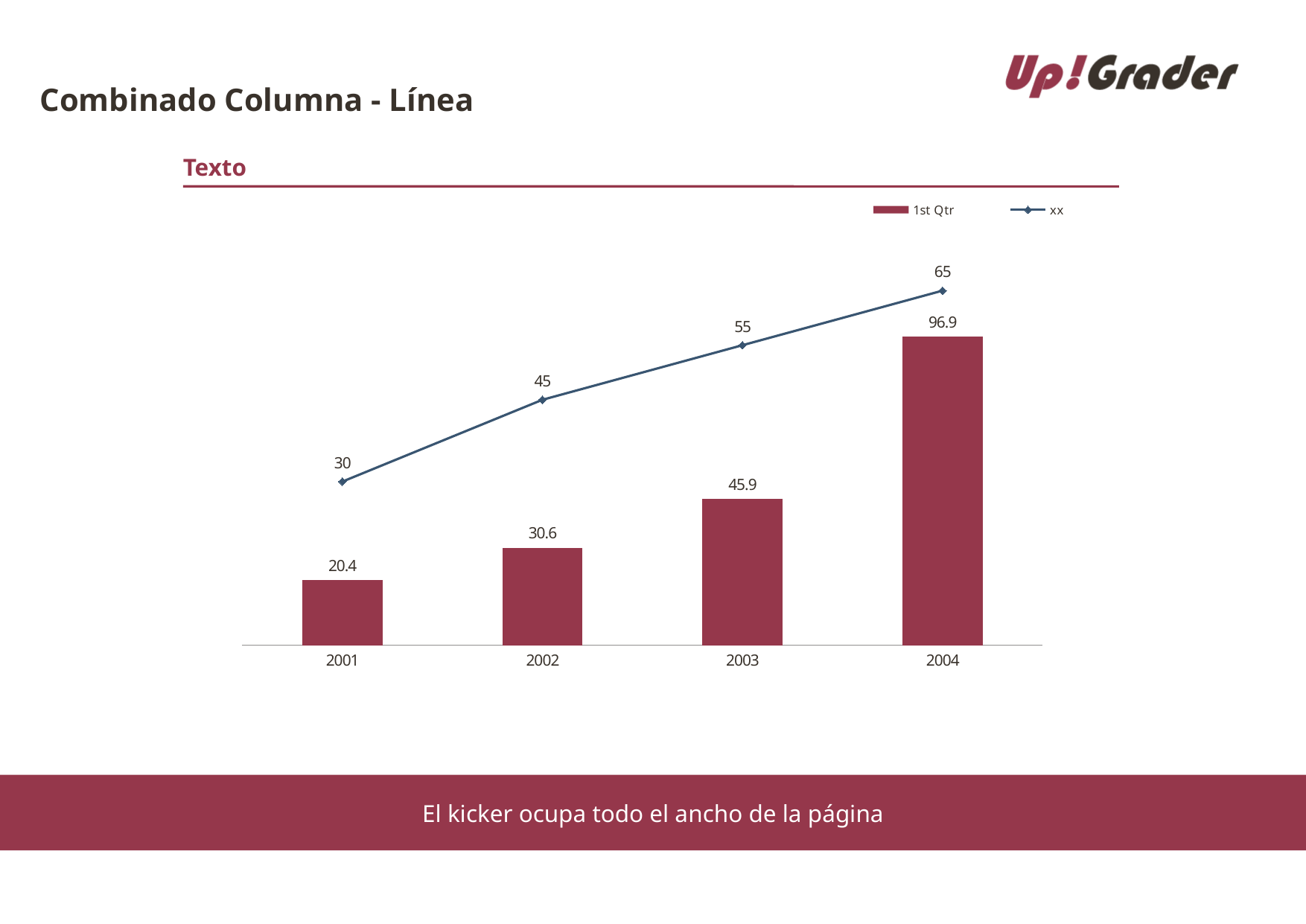
Which year has the highest 1st Qtr bar value? 2004 How many series does the legend list? 2 What kind of chart is shown on the slide? Combined bar and line chart Do the 1st Qtr bar values rise or fall from 2001 to 2004? Rise What is the value of the 1st Qtr bar for 2001? 20.4 What is the difference between the 1st Qtr bar values for 2004 and 2003? 51 What is the value of the xx line series for 2002? 45 What is the value of the 1st Qtr bar for 2003? 45.9 Which is larger: the 1st Qtr bar value for 2002 or the xx line value for 2002? xx line value for 2002 How many years are shown on the x axis? 4 Which year has the lowest value on the xx line series? 2001 What is the difference between the xx line values for 2004 and 2001? 35